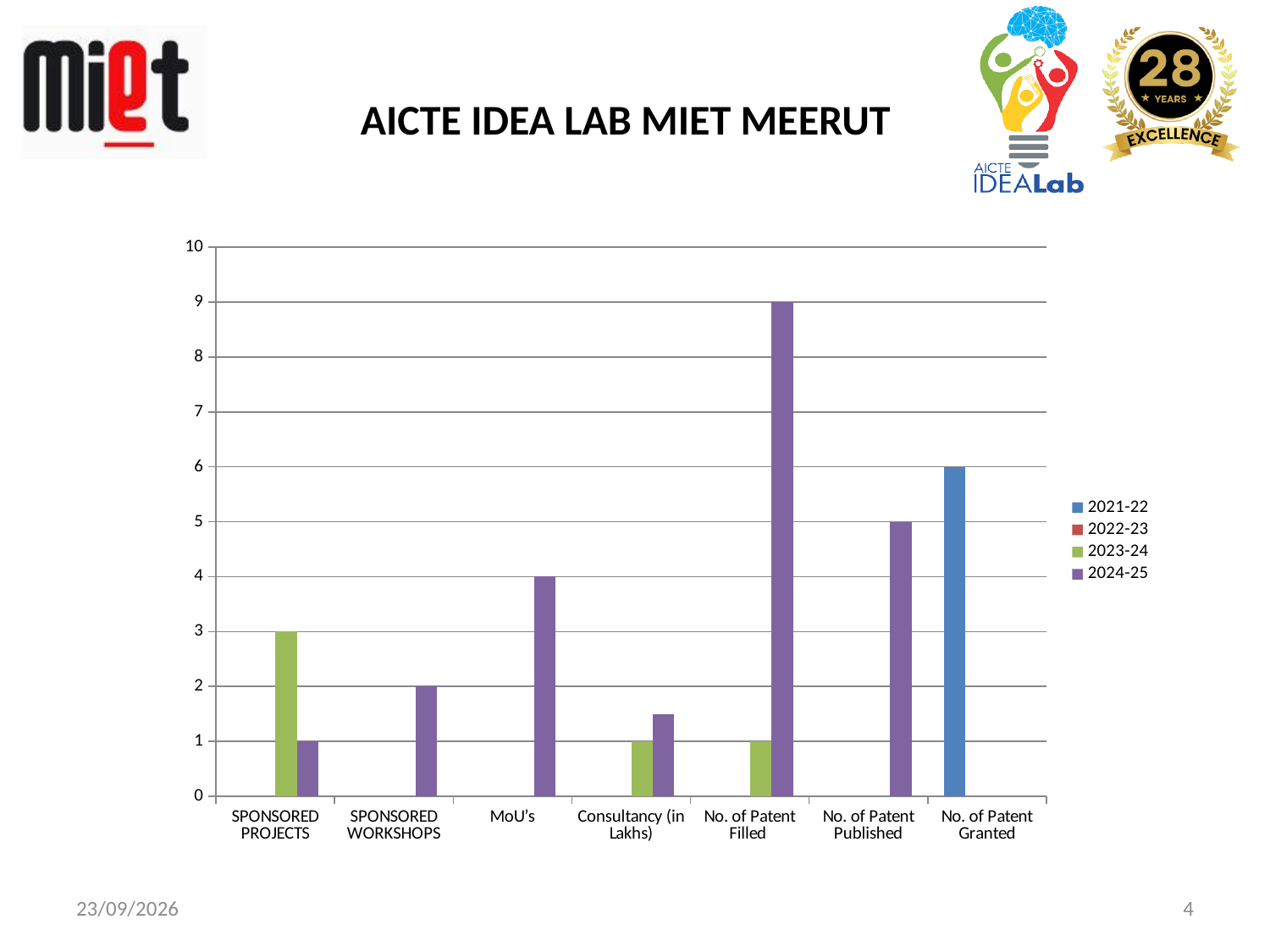
Which legend entry is shown in purple? 2024-25 Which is larger: the 2024-25 value for No. of Patent Published or the 2024-25 value for SPONSORED WORKSHOPS? No. of Patent Published What is the value for 2024-25 in the MoU's category? 4 How many categories are shown on the x axis? 7 What is the value for 2024-25 in the No. of Patent Filled category? 9 What is the value for 2021-22 in the No. of Patent Granted category? 6 Is the 2024-25 value for Consultancy (in Lakhs) greater or less than 2? less What is the difference between the 2024-25 value for No. of Patent Filled and the 2024-25 value for No. of Patent Published? 4 What is the value for 2023-24 in the SPONSORED PROJECTS category? 3 What type of chart is shown on the slide? bar chart How many series does the legend list? 4 Which category has the highest bar in the chart? No. of Patent Filled